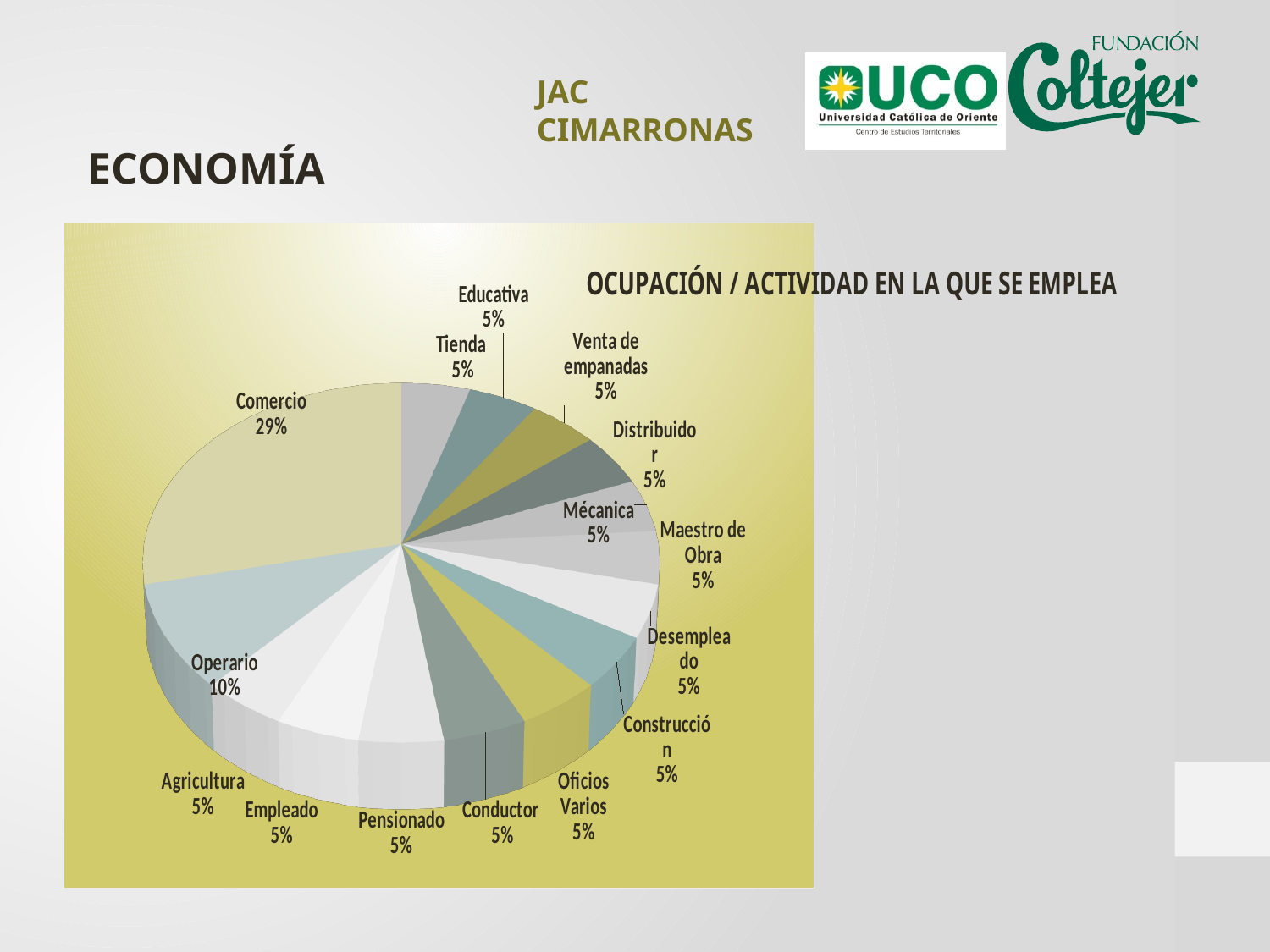
What is the difference between the Operario share and the Pensionado share? 5% What is the value shown for Operario? 10% How many occupation categories are shown in the pie chart? 15 Which occupation has the largest share of the pie? Comercio What is the title of the chart? OCUPACIÓN / ACTIVIDAD EN LA QUE SE EMPLEA Which is larger, the share for Operario or the share for Conductor? Operario What is the value shown for Desempleado? 5% What is the combined share of Comercio and Operario? 39% What is the difference between the Comercio share and the Operario share? 19% What is the value shown for Agricultura? 5% What share of the pie does Comercio represent? 29% What kind of chart is shown on the slide? Pie chart